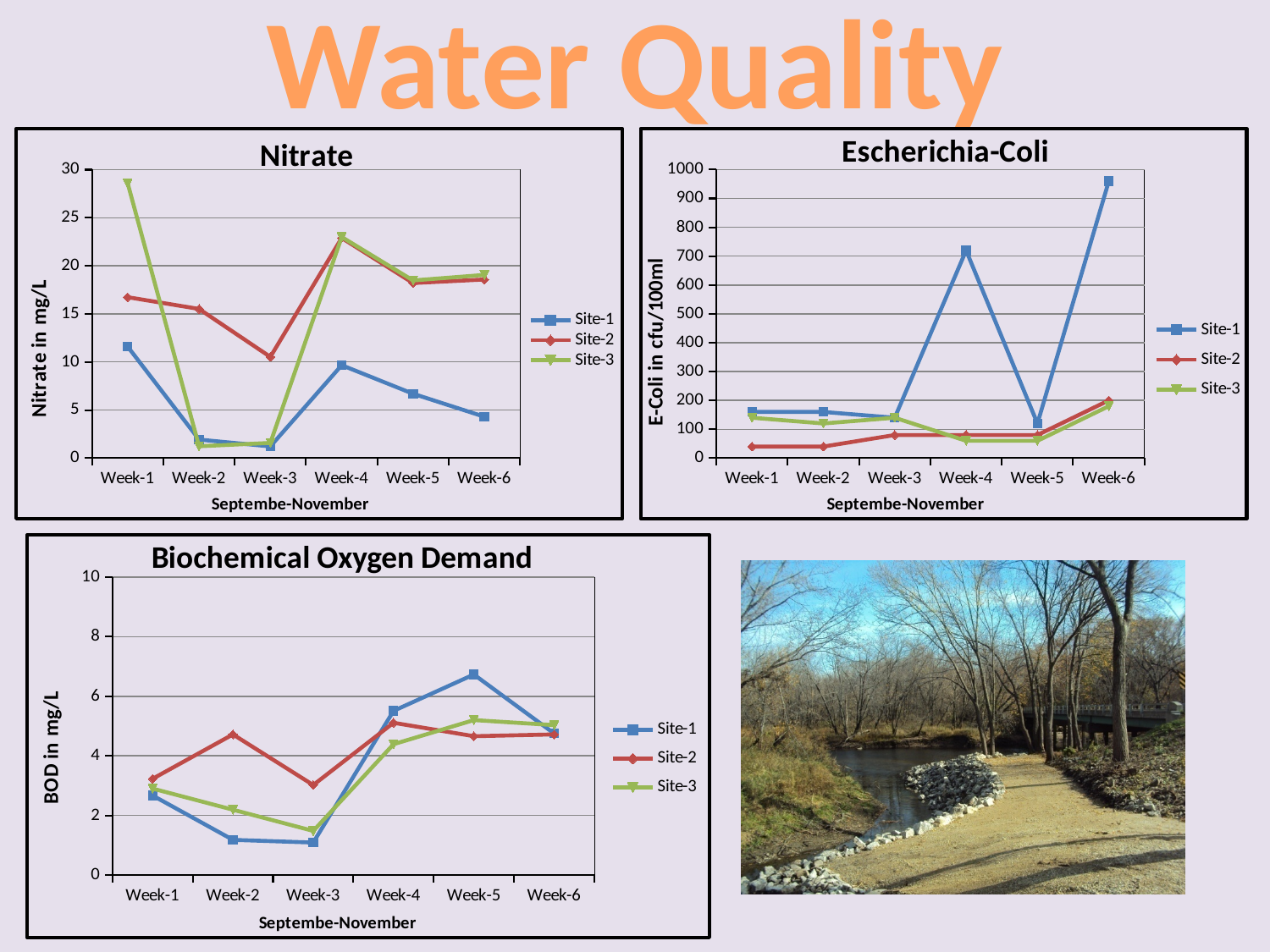
In the Nitrate chart, which site has the highest value at Week-1? Site-3 How many series does the legend of the Escherichia-Coli chart list? 3 In the Escherichia-Coli chart, which site has the highest value at Week-4? Site-1 What kind of chart is the Nitrate chart? line chart In the Biochemical Oxygen Demand chart, which is larger at Week-2, Site-1 or Site-2? Site-2 In the Escherichia-Coli chart, is the value for Site-2 at Week-1 greater or less than 100? less How many weeks are shown on the x axis of the Biochemical Oxygen Demand chart? 6 In the Biochemical Oxygen Demand chart, is the value for Site-1 at Week-5 greater or less than 6? greater In the Biochemical Oxygen Demand chart, does the Site-1 line rise or fall from Week-1 to Week-2? fall In the Nitrate chart, is the value for Site-3 at Week-1 greater or less than 25? greater In the Nitrate chart, which site has the lowest value at Week-6? Site-1